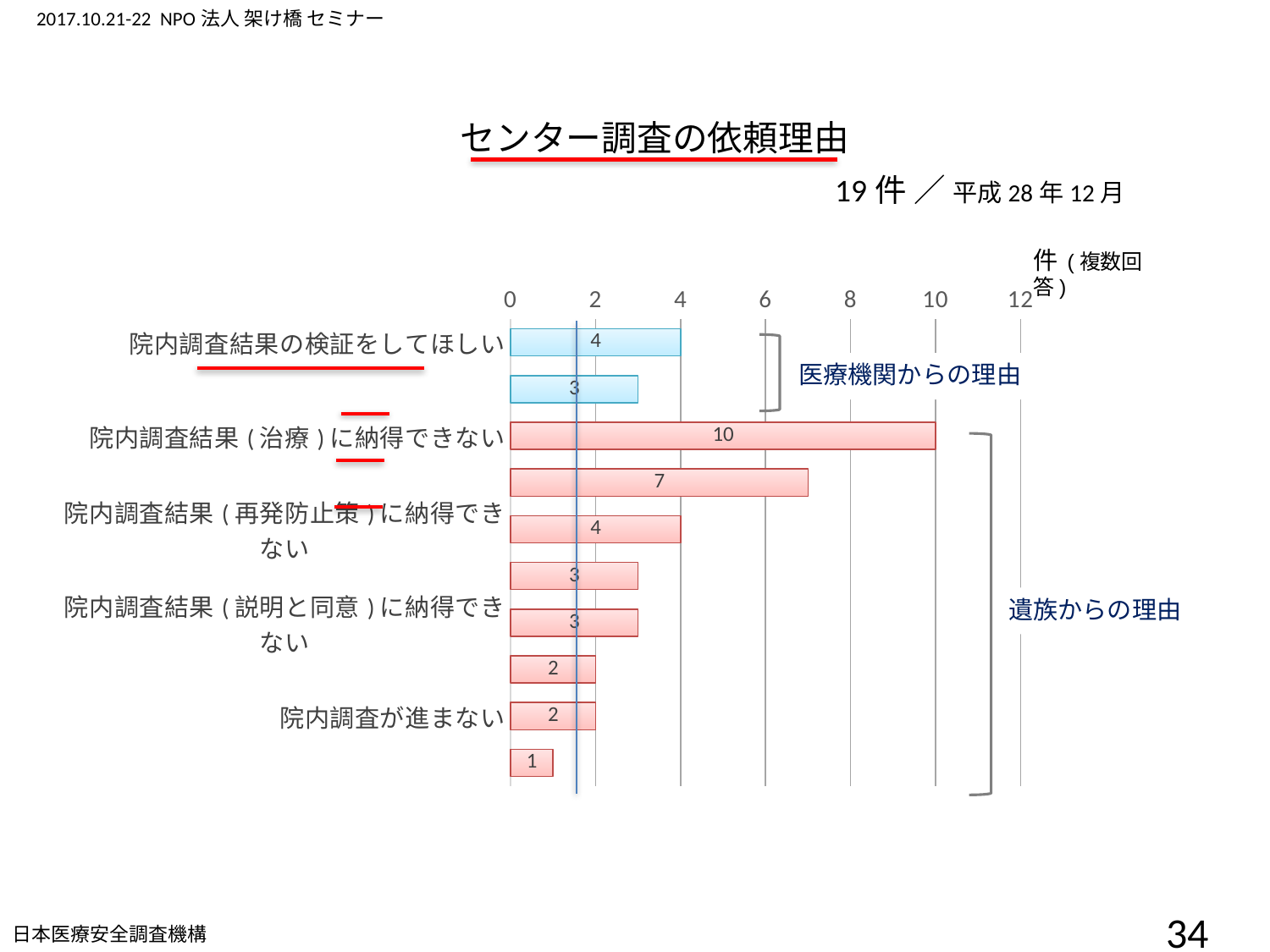
What is the value for 院内調査結果の検証をしてほしい? 4 What is the difference between the values for 院内調査結果(治療)に納得できない and 院内調査結果(再発防止策)に納得できない? 6 What is the smallest value shown on any bar in the chart? 1 What is the value for 院内調査結果(再発防止策)に納得できない? 4 How many bars are plotted in the chart? 10 What is the value for 院内調査が進まない? 2 What kind of chart is shown on the slide? bar chart What is the title of the chart? センター調査の依頼理由 Which is larger, the value for 院内調査結果(説明と同意)に納得できない or the value for 院内調査が進まない? 院内調査結果(説明と同意)に納得できない Which labeled category has the highest value? 院内調査結果(治療)に納得できない What is the value for 院内調査結果(説明と同意)に納得できない? 3 What is the value for 院内調査結果(治療)に納得できない? 10